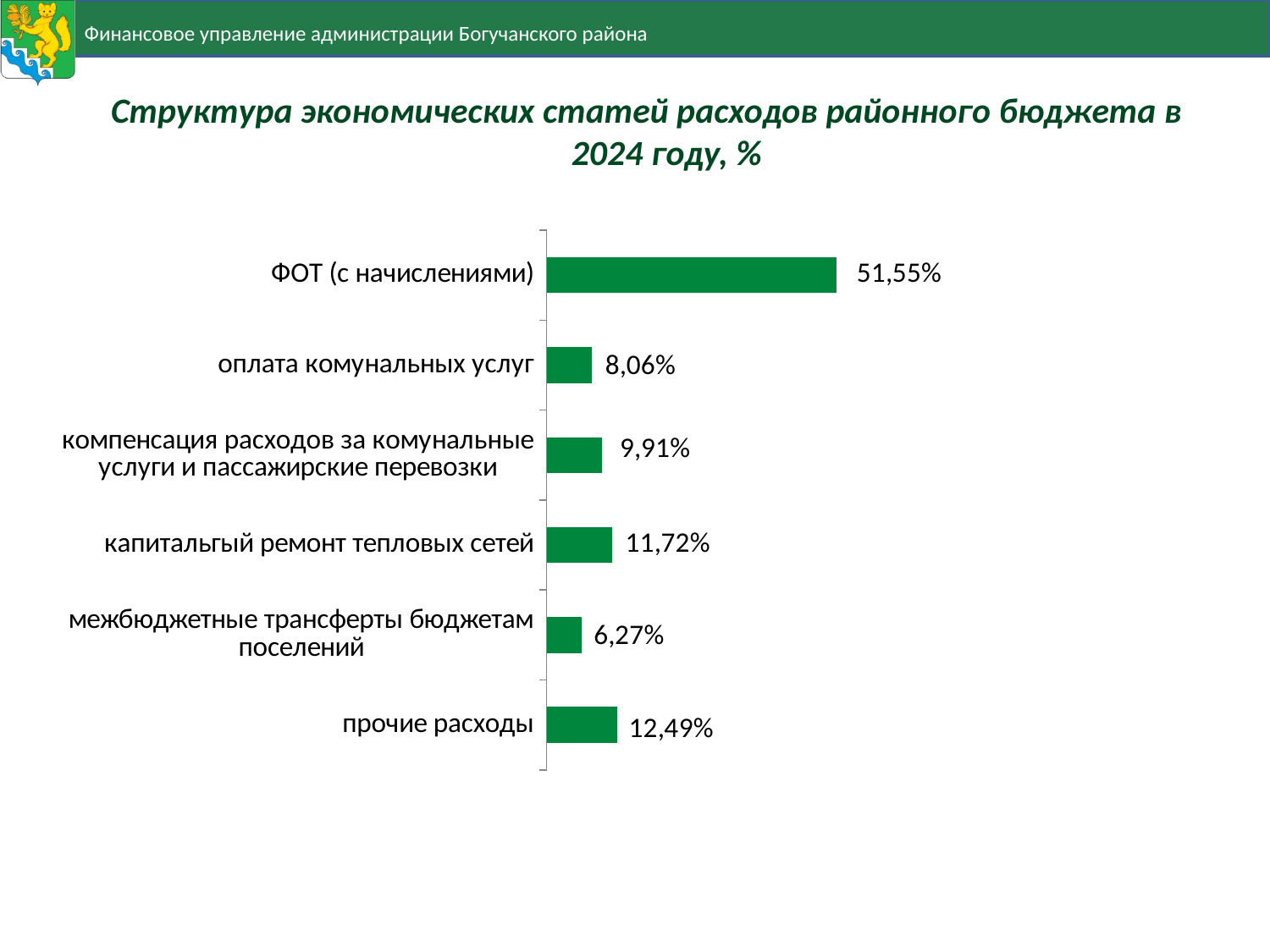
How many categories are shown in the chart? 6 What is the value for прочие расходы? 12,49% What is the title of the chart? Структура экономических статей расходов районного бюджета в 2024 году, % Which is larger: компенсация расходов за коммунальные услуги и пассажирские перевозки or оплата коммунальных услуг? компенсация расходов за коммунальные услуги и пассажирские перевозки Which category has the lowest value? межбюджетные трансферты бюджетам поселений Which category has the highest value? ФОТ (с начислениями) What is the difference between the values for капитальгый ремонт тепловых сетей and оплата коммунальных услуг? 3,66% What is the value for ФОТ (с начислениями)? 51,55% What is the value for капитальгый ремонт тепловых сетей? 11,72% What is the value for оплата коммунальных услуг? 8,06% What kind of chart is shown on the slide? bar chart What is the difference between the values for ФОТ (с начислениями) and прочие расходы? 39,06%